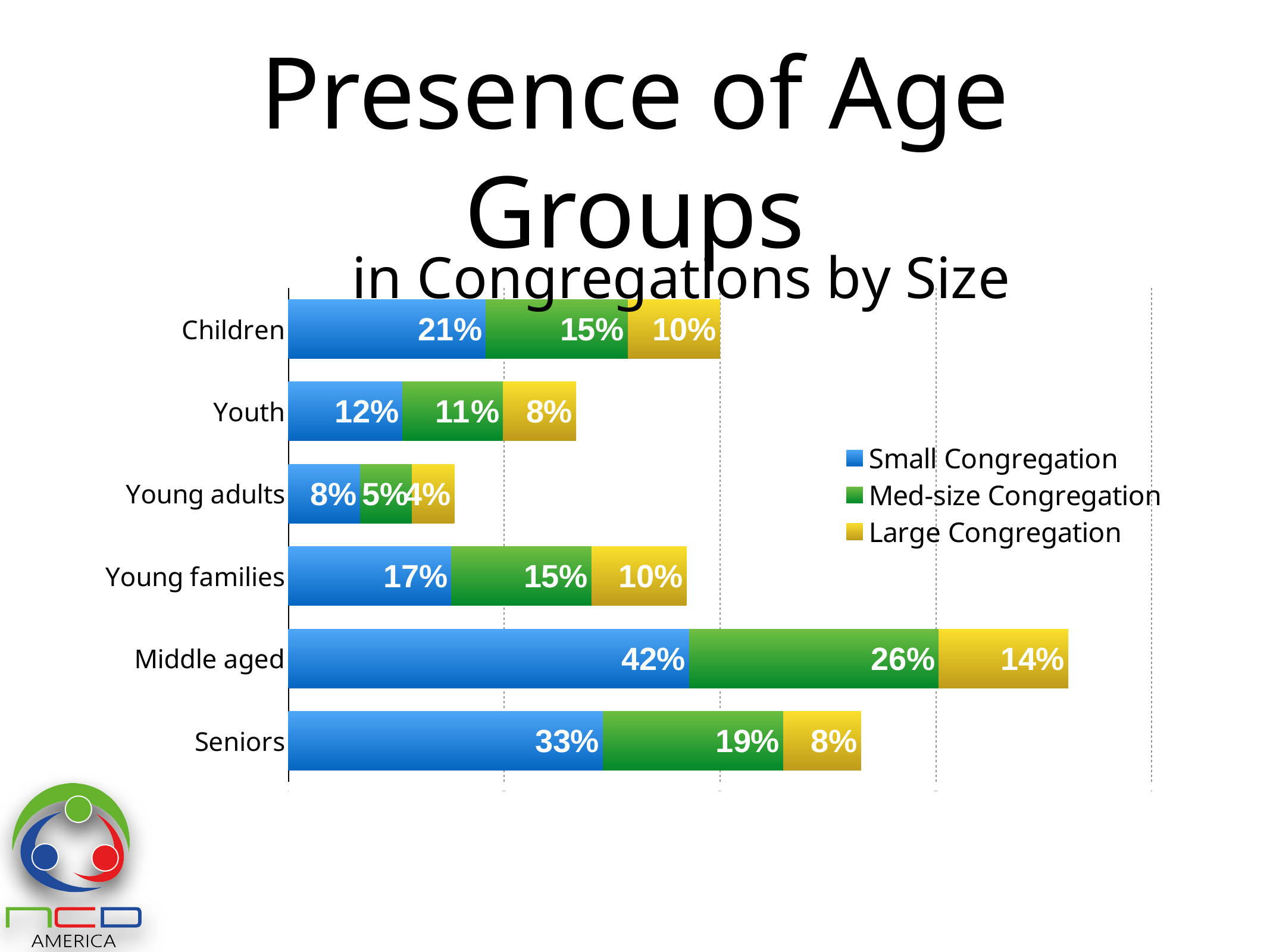
Which age group has the lowest Large Congregation value? Young adults What is the total of the stacked bar for Young adults? 17% What is the Small Congregation value for Middle aged? 42% Which colour represents Large Congregation in the legend? Yellow Which is larger: the Med-size Congregation value for Children or for Youth? Children How many age group categories are plotted? 6 What is the Large Congregation value for Youth? 8% What type of chart is shown on the slide? Stacked bar chart Which age group has the highest Small Congregation value? Middle aged What is the Med-size Congregation value for Seniors? 19% How many series does the legend list? 3 What is the difference between the Small Congregation values for Seniors and Children? 12%